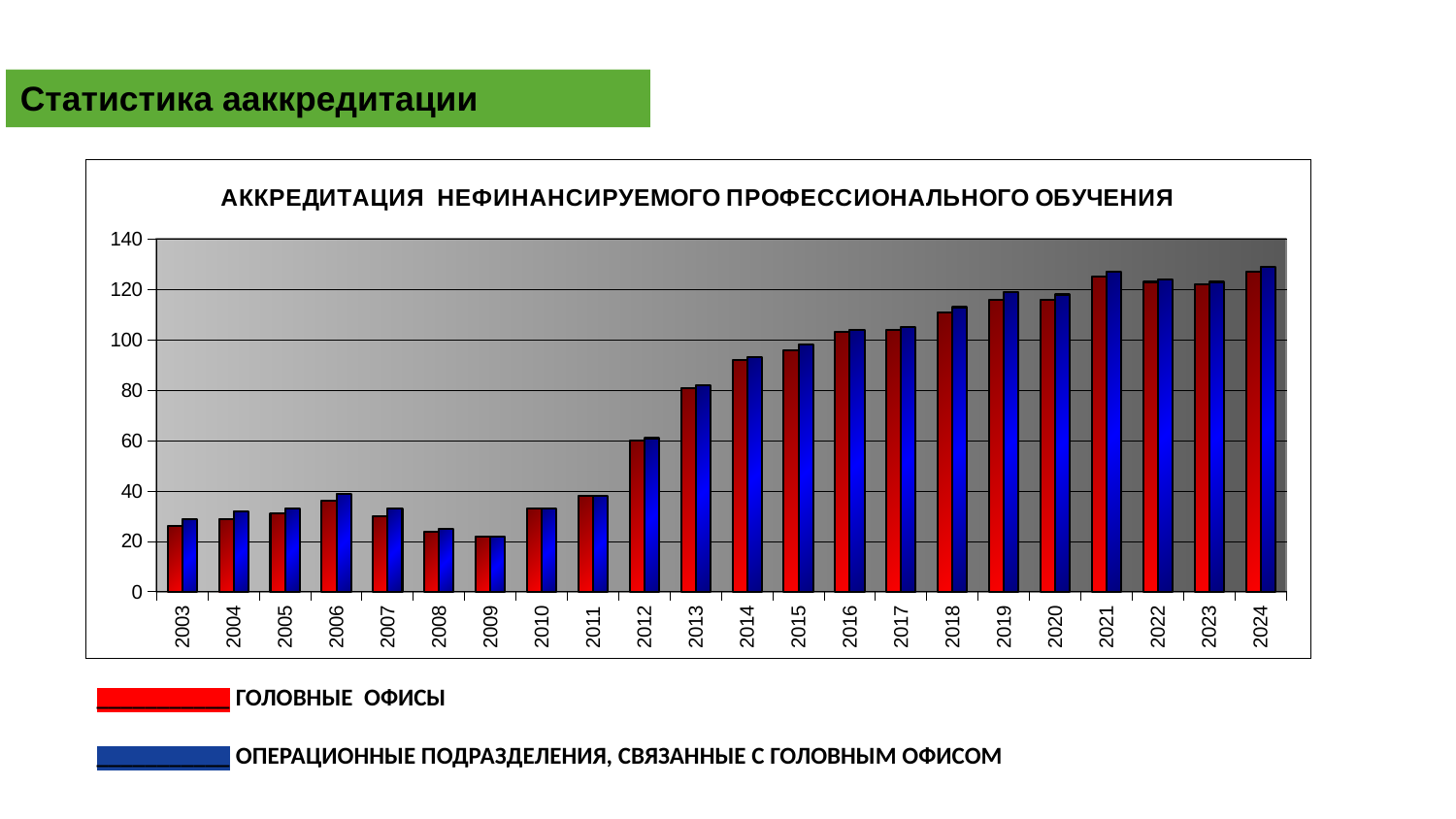
Is the value for ОПЕРАЦИОННЫЕ ПОДРАЗДЕЛЕНИЯ, СВЯЗАННЫЕ С ГОЛОВНЫМ ОФИСОМ in 2009 greater or less than 40? less Do the values for ГОЛОВНЫЕ ОФИСЫ generally rise or fall from 2003 to 2024? rise How many series does the legend list? 2 Is the value for ГОЛОВНЫЕ ОФИСЫ in 2014 greater or less than 80? greater How many years are shown on the x axis of the chart? 22 Which colour represents ГОЛОВНЫЕ ОФИСЫ in the chart? red Which year has the larger value for ГОЛОВНЫЕ ОФИСЫ, 2009 or 2014? 2014 What kind of chart is shown on the slide? bar chart Is the value for ГОЛОВНЫЕ ОФИСЫ in 2018 greater or less than 100? greater What is the title of the chart? АККРЕДИТАЦИЯ НЕФИНАНСИРУЕМОГО ПРОФЕССИОНАЛЬНОГО ОБУЧЕНИЯ